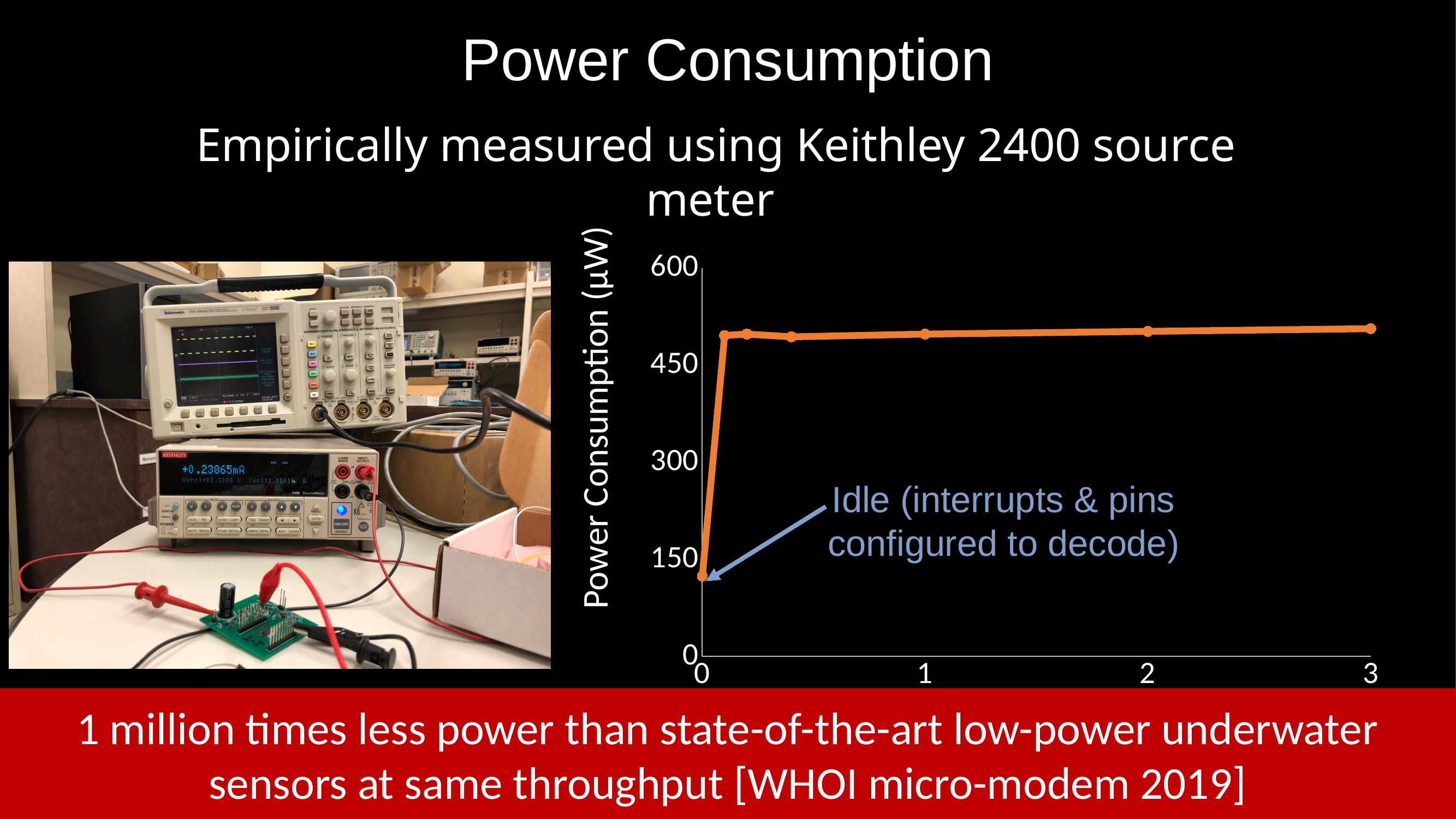
What does the annotation on the chart say the point at x = 0 represents? Idle (interrupts & pins configured to decode) Is the power consumption at x = 1 greater or less than 450? greater What is the largest value shown on the x-axis of the chart? 3 What is the label of the y-axis of the chart? Power Consumption (µW) Is the power consumption at x = 2 greater or less than 300? greater What kind of chart is shown on the slide? line chart Which has higher power consumption: the point at x = 0 or the point at x = 1? x = 1 At which x value is the power consumption lowest? 0 What is the highest value shown on the y-axis of the chart? 600 Is the power consumption at x = 3 greater or less than 600? less Does the power consumption rise or fall between x = 0 and x = 1? rise